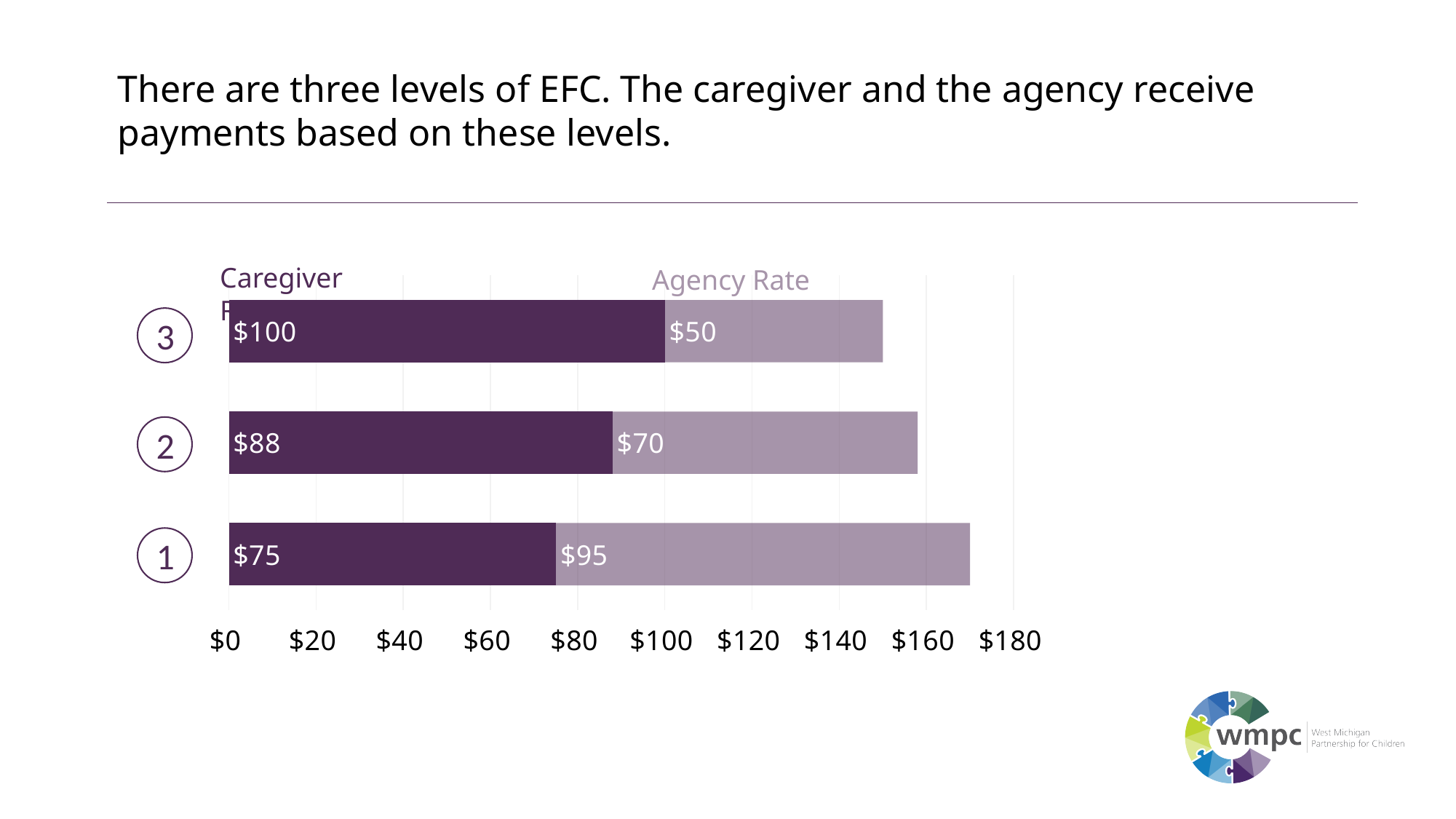
What kind of chart is shown on the slide? Stacked bar chart What is the total of the stacked bar for level 2? $158 Which is larger for level 1, the Caregiver Rate or the Agency Rate? Agency Rate How many levels are shown in the chart? 3 What is the Agency Rate for level 2? $70 What is the difference between the Caregiver Rate and the Agency Rate for level 3? $50 What is the Agency Rate for level 1? $95 What is the total of the stacked bar for level 1? $170 Which series is shown in the lighter purple colour? Agency Rate What is the Caregiver Rate for level 3? $100 Which level has the highest Caregiver Rate? 3 Which level has the lowest Agency Rate? 3